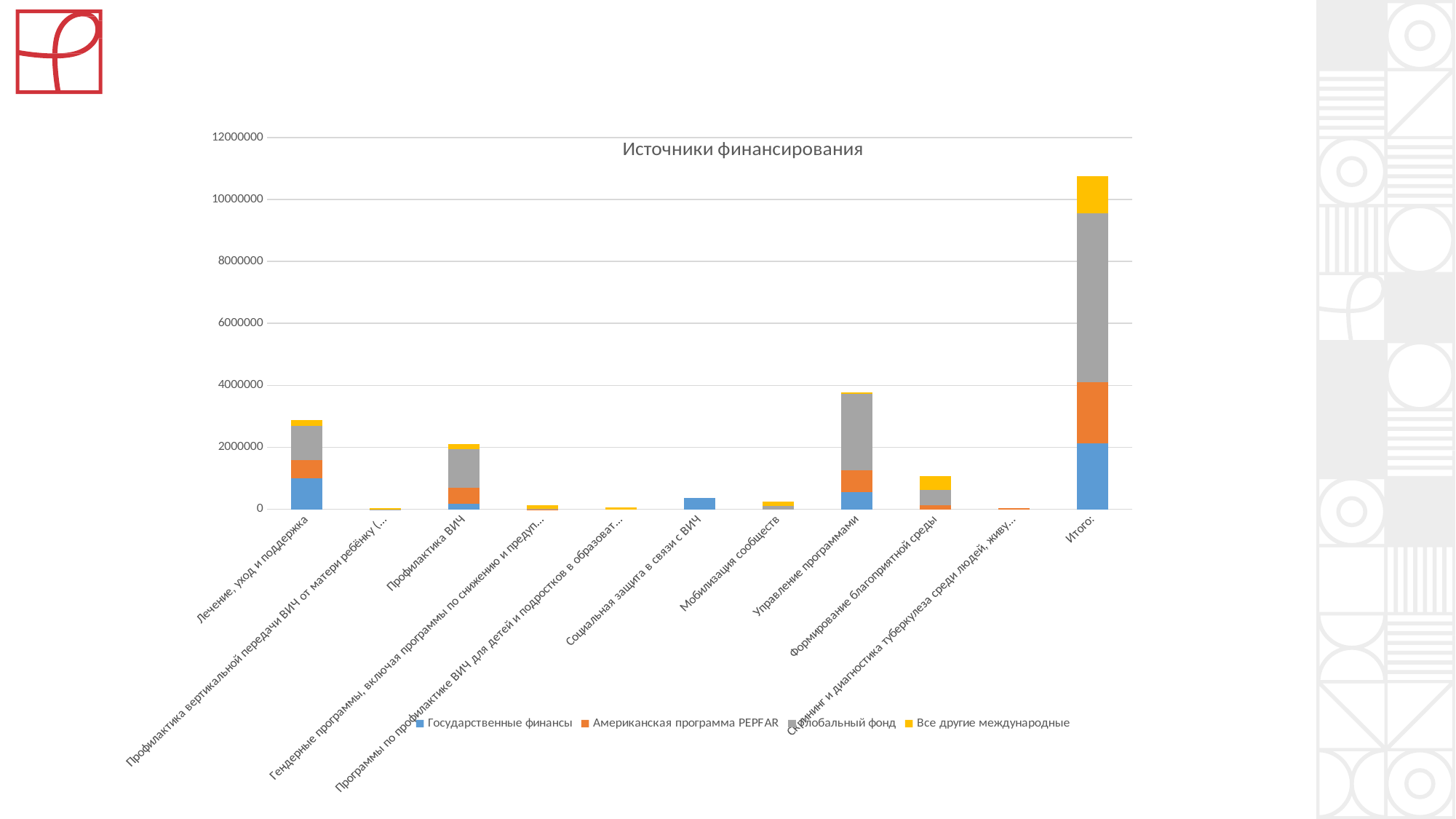
Which series is shown in grey in the chart legend? Глобальный фонд Is the total value of the bar for Управление программами greater or less than 2000000? greater Is the total value of the bar for Лечение, уход и поддержка greater or less than 4000000? less What is the title of the chart? Источники финансирования How many series does the chart legend list? 4 How many categories are shown along the x axis of the chart? 11 Which has the taller stacked bar: Управление программами or Лечение, уход и поддержка? Управление программами Which category has the tallest stacked bar in the chart? Итого: Is the total value of the bar for Итого: greater or less than 10000000? greater What kind of chart is shown on the slide? Stacked bar chart